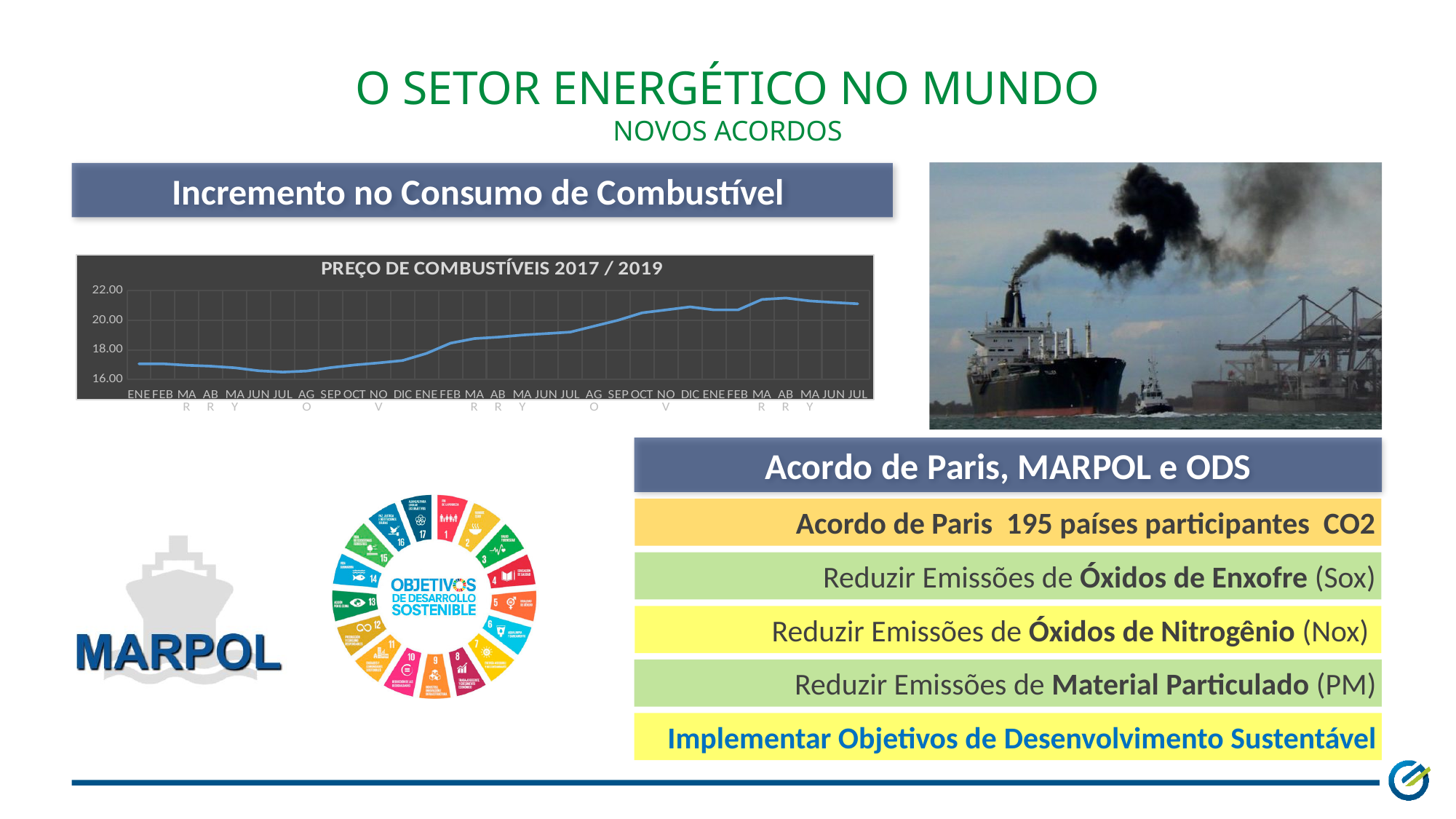
In the chart "PREÇO DE COMBUSTÍVEIS 2017 / 2019", is the value for the last JUL (July 2019) greater or less than 20.00? greater In the chart "PREÇO DE COMBUSTÍVEIS 2017 / 2019", which is larger: the value for the first DIC (December 2017) or the second DIC (December 2018)? the second DIC (December 2018) What colour is the line in the chart "PREÇO DE COMBUSTÍVEIS 2017 / 2019"? blue What is the title of the chart on the slide? PREÇO DE COMBUSTÍVEIS 2017 / 2019 In the chart "PREÇO DE COMBUSTÍVEIS 2017 / 2019", is the value for the first JUL (July 2017) greater or less than 18.00? less In the chart "PREÇO DE COMBUSTÍVEIS 2017 / 2019", is the value for the first DIC (December 2017) greater or less than 18.00? less In the chart "PREÇO DE COMBUSTÍVEIS 2017 / 2019", do the values generally rise or fall from left to right along the x axis? rise What kind of chart is shown under the heading "Incremento no Consumo de Combustível"? line chart In the chart "PREÇO DE COMBUSTÍVEIS 2017 / 2019", which is larger: the value for the first ENE (January 2017) or the value for the last JUL (July 2019)? the last JUL (July 2019) How many monthly points are plotted along the x axis of the chart "PREÇO DE COMBUSTÍVEIS 2017 / 2019"? 31